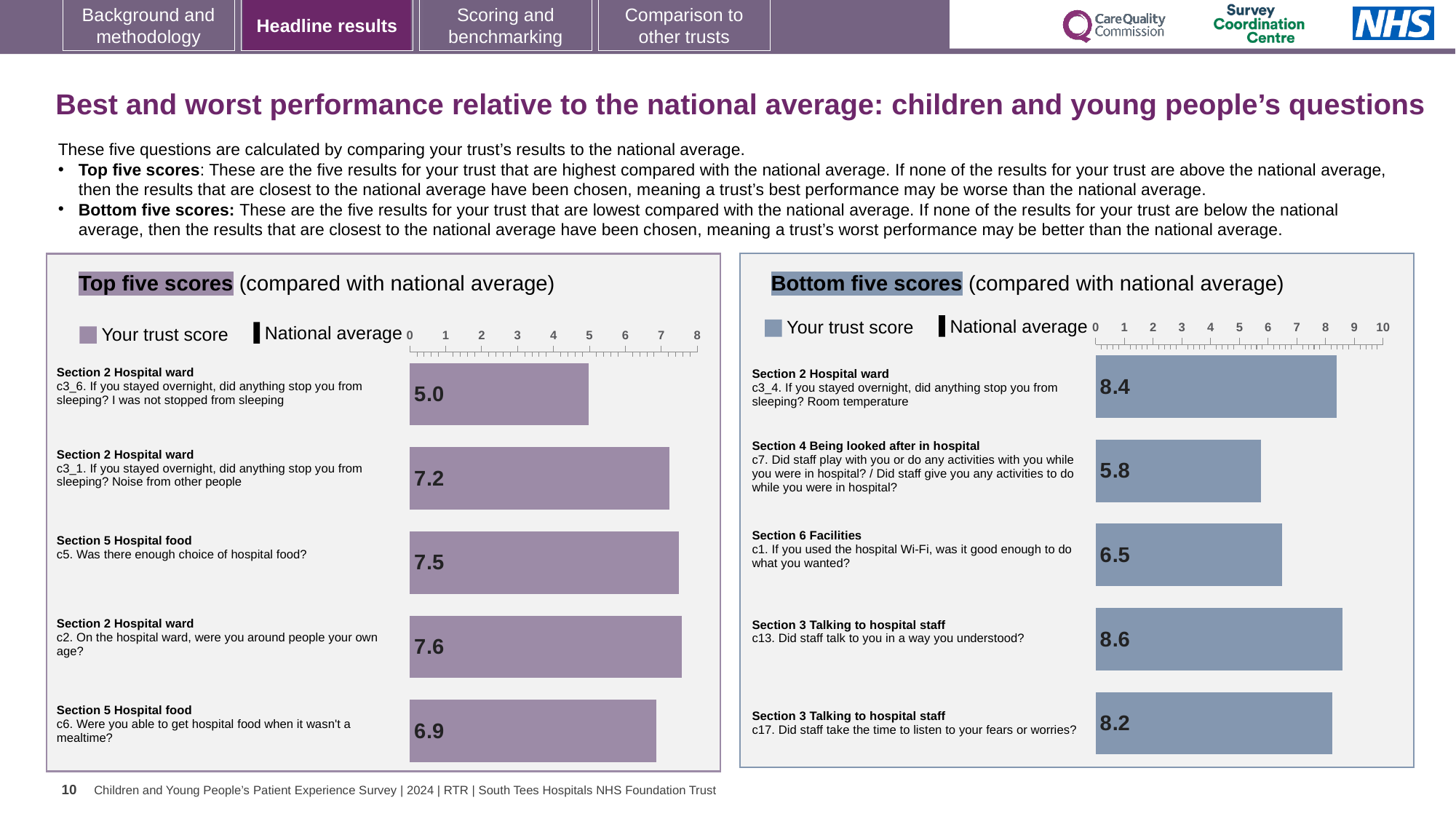
In the Top five scores chart, what is the trust score for c2 (were you around people your own age)? 7.6 How many entries does the legend of the Bottom five scores chart list? 2 In the Bottom five scores chart, what is the trust score for c13 (did staff talk to you in a way you understood)? 8.6 What type of chart is the Top five scores chart? Bar chart In the Top five scores chart, which question has the highest trust score? c2. On the hospital ward, were you around people your own age? In the Bottom five scores chart, what is the trust score for c7 (did staff play with you or do any activities with you)? 5.8 In the Bottom five scores chart, which question has the lowest trust score? c7. Did staff play with you or do any activities with you while you were in hospital? In the Top five scores chart, what is the trust score for c3_6 (I was not stopped from sleeping)? 5.0 In the Top five scores chart, what is the difference between the trust scores for c5 (enough choice of hospital food) and c6 (food when it wasn't a mealtime)? 0.6 In the Bottom five scores chart, what is the difference between the trust scores for c13 and c1 (hospital Wi-Fi)? 2.1 In the Top five scores chart, which has the larger trust score: c3_1 (noise from other people) or c3_6 (I was not stopped from sleeping)? c3_1 (noise from other people) How many questions are plotted in the Bottom five scores chart? 5